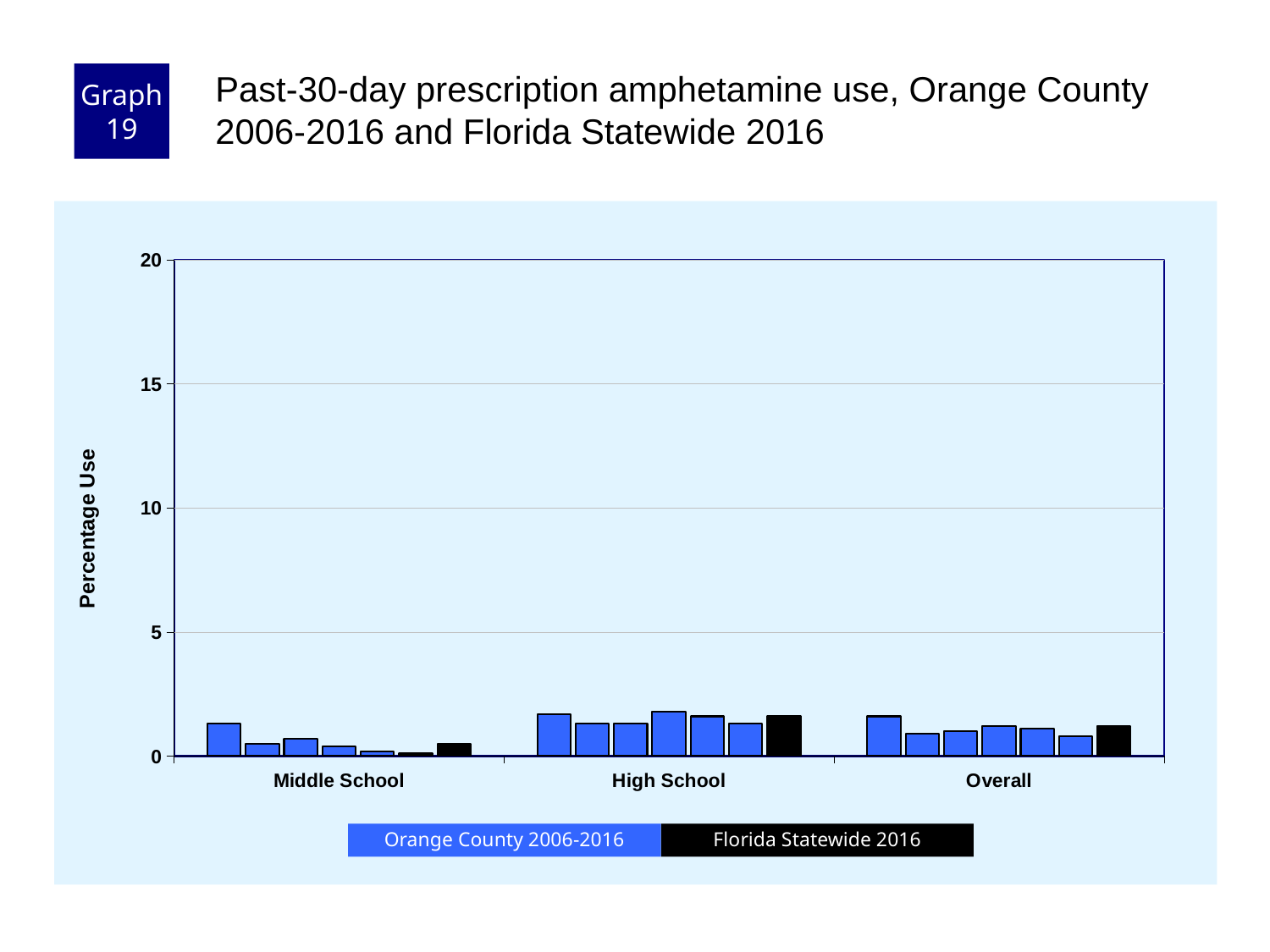
How many series does the legend list? 2 Is the Florida Statewide 2016 value for Overall greater or less than 5? less Which category has the lowest Florida Statewide 2016 value? Middle School What kind of chart is shown on the slide? bar chart What is the label on the y axis? Percentage Use Which is larger, the Florida Statewide 2016 value for High School or for Middle School? High School Which is larger, the Florida Statewide 2016 value for Overall or for Middle School? Overall Which category has the highest Florida Statewide 2016 value? High School Is the Florida Statewide 2016 value for Middle School greater or less than 5? less Is the Florida Statewide 2016 value for High School greater or less than 5? less What is the title of the chart? Past-30-day prescription amphetamine use, Orange County 2006-2016 and Florida Statewide 2016 How many categories are shown on the x axis? 3